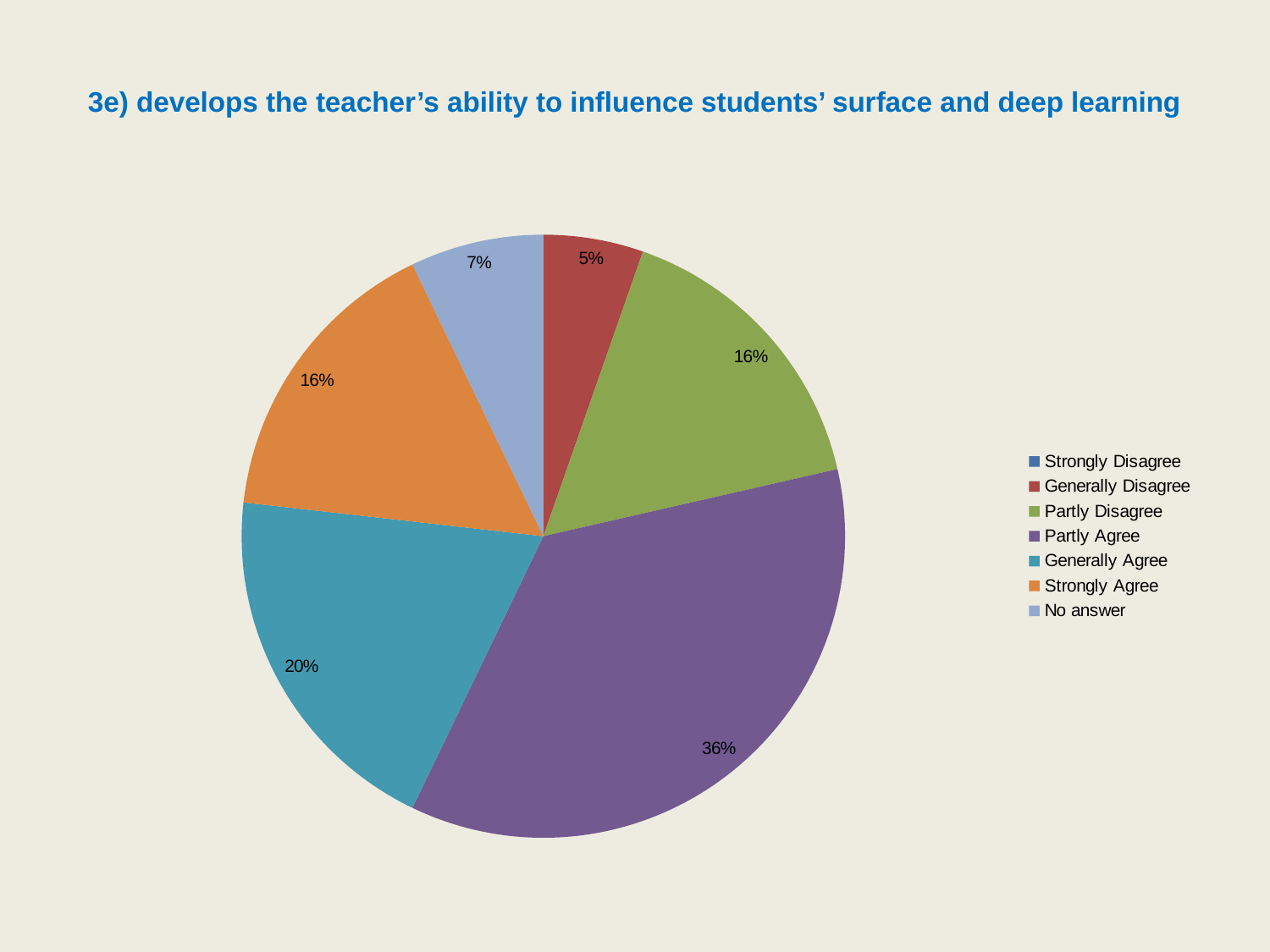
What is the title of the chart? 3e) develops the teacher's ability to influence students' surface and deep learning Which response category has the largest share of the pie? Partly Agree What percentage of respondents chose Generally Disagree? 5% What percentage of respondents chose Generally Agree? 20% What kind of chart is shown on the slide? pie chart What percentage of respondents chose Partly Agree? 36% What is the difference in percentage points between Partly Agree and Generally Agree? 16 How many response categories does the legend list? 7 What is the difference in percentage points between No answer and Generally Disagree? 2 What percentage of respondents gave No answer? 7% What percentage of respondents chose Strongly Agree? 16% Which is larger, the share for Generally Agree or the share for Strongly Agree? Generally Agree